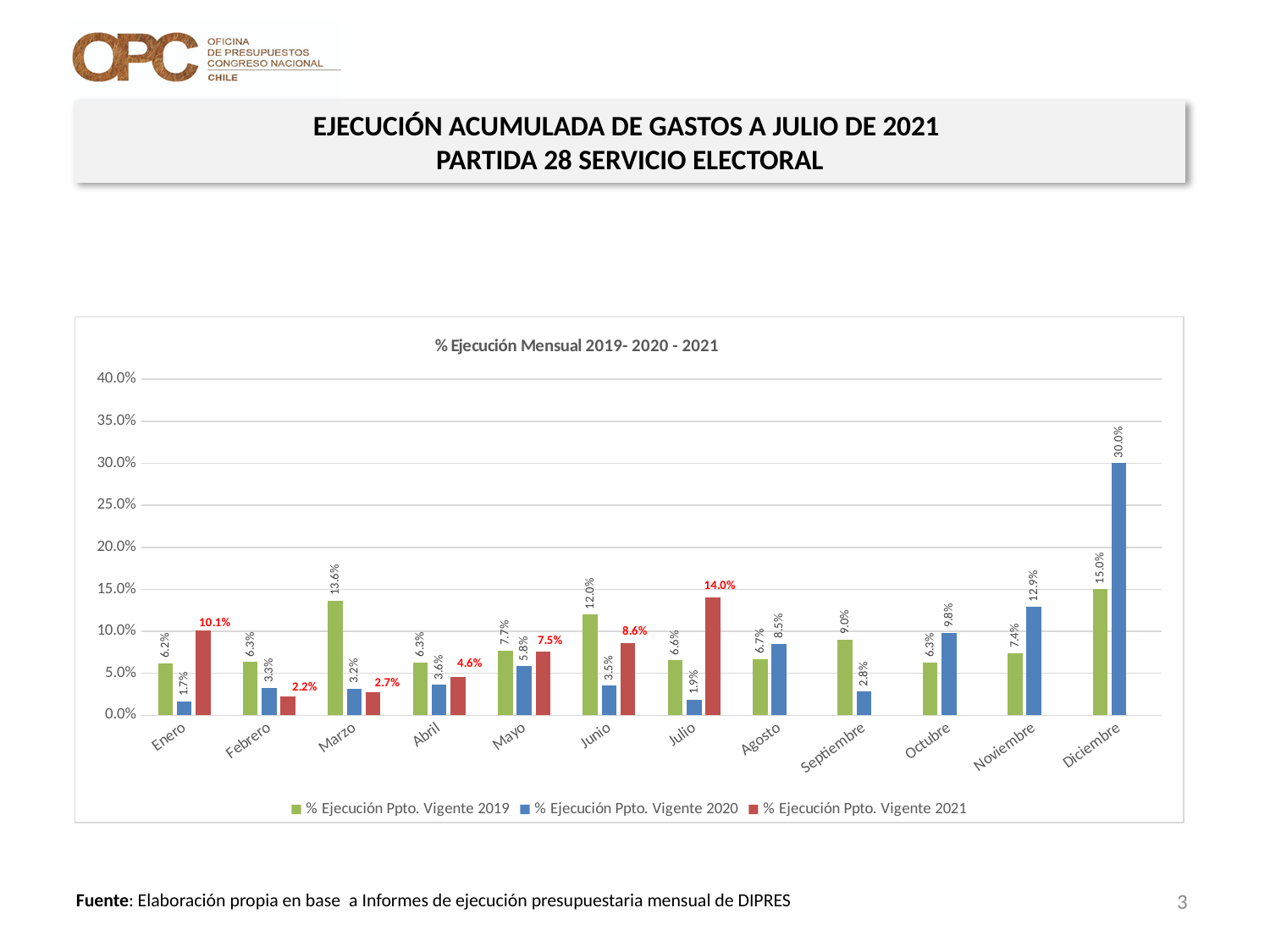
What is the value for % Ejecución Ppto. Vigente 2019 in Marzo? 13.6% What is the value for % Ejecución Ppto. Vigente 2021 in Julio? 14.0% How many series does the legend list? 3 What kind of chart is shown on the slide? Bar chart Which month has the highest value for % Ejecución Ppto. Vigente 2021? Julio Which month has the lowest value for % Ejecución Ppto. Vigente 2020? Enero In Junio, which series is larger: % Ejecución Ppto. Vigente 2019 or % Ejecución Ppto. Vigente 2021? % Ejecución Ppto. Vigente 2019 What is the value for % Ejecución Ppto. Vigente 2020 in Diciembre? 30.0% Is the value for % Ejecución Ppto. Vigente 2020 in Diciembre greater or less than 25.0%? greater How many months are shown on the x axis? 12 What is the title of the chart? % Ejecución Mensual 2019- 2020 - 2021 What is the difference between the 2021 and 2020 values in Enero? 8.4%